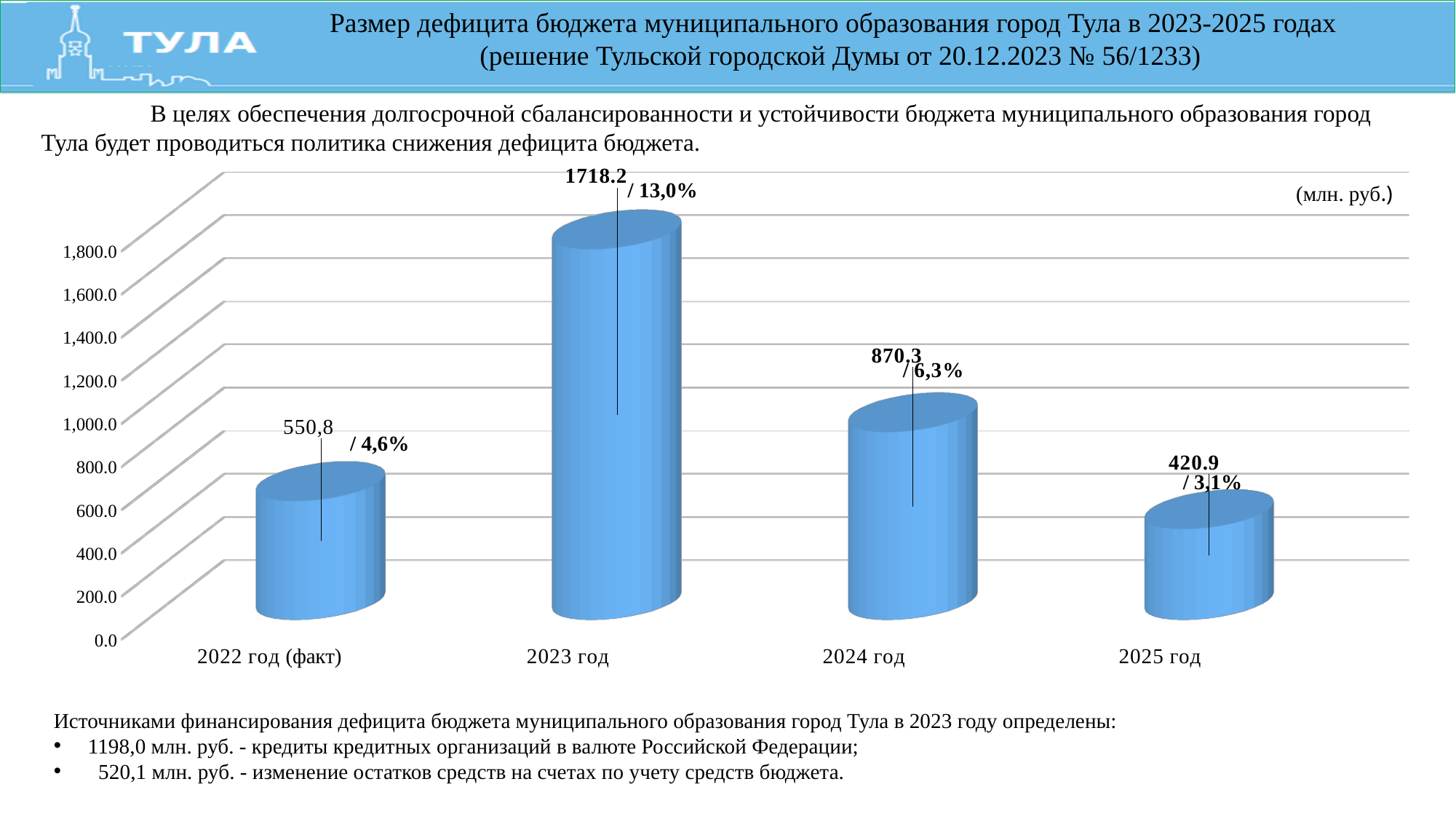
Is the value for 2024 год greater or less than 1,000.0? less Which year has the lowest budget deficit on the chart? 2025 год From 2023 год to 2025 год, do the values rise or fall? fall Which year has the highest budget deficit on the chart? 2023 год How many years (categories) are shown on the chart? 4 What is the value shown for 2025 год? 420.9 What kind of chart is shown on the slide? bar chart What is the budget deficit value shown for 2023 год? 1718.2 What percentage is shown next to the 2024 год bar? 6,3% Which is larger, the value for 2024 год or the value for 2022 год (факт)? 2024 год What is the value shown for 2022 год (факт)? 550,8 What is the difference between the values for 2023 год and 2025 год? 1297.3